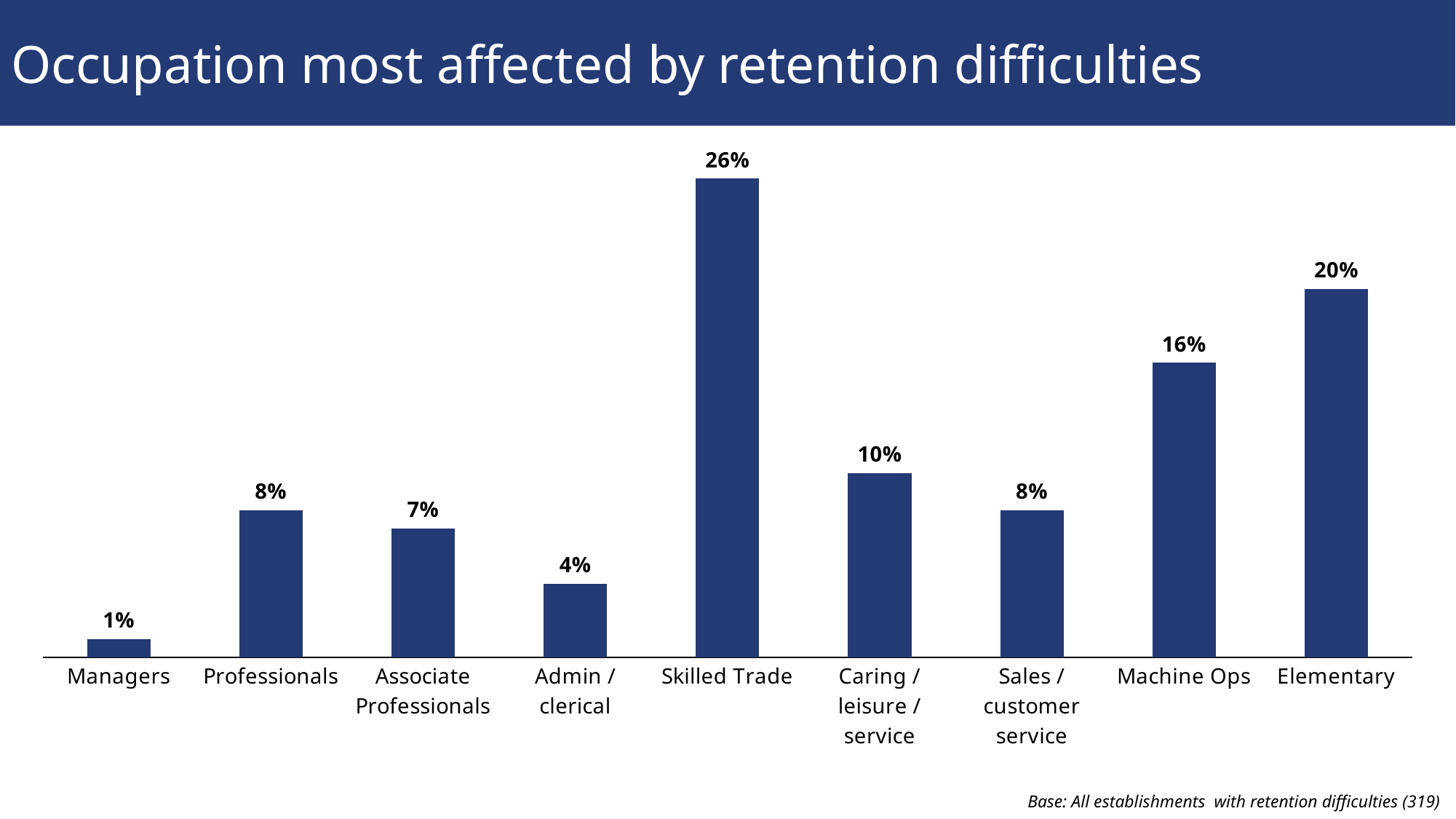
What is the value for Skilled Trade? 26% Which occupation has the lowest value? Managers What is the difference between the values for Skilled Trade and Caring / leisure / service? 16% What is the value for Machine Ops? 16% Which occupation has the highest value? Skilled Trade What is the title of the chart? Occupation most affected by retention difficulties How many occupation categories are shown in the chart? 9 What kind of chart is shown on the slide? Bar chart Which is larger, the value for Caring / leisure / service or the value for Sales / customer service? Caring / leisure / service What is the value for Admin / clerical? 4% Which is larger, the value for Professionals or the value for Associate Professionals? Professionals What is the difference between the values for Elementary and Machine Ops? 4%